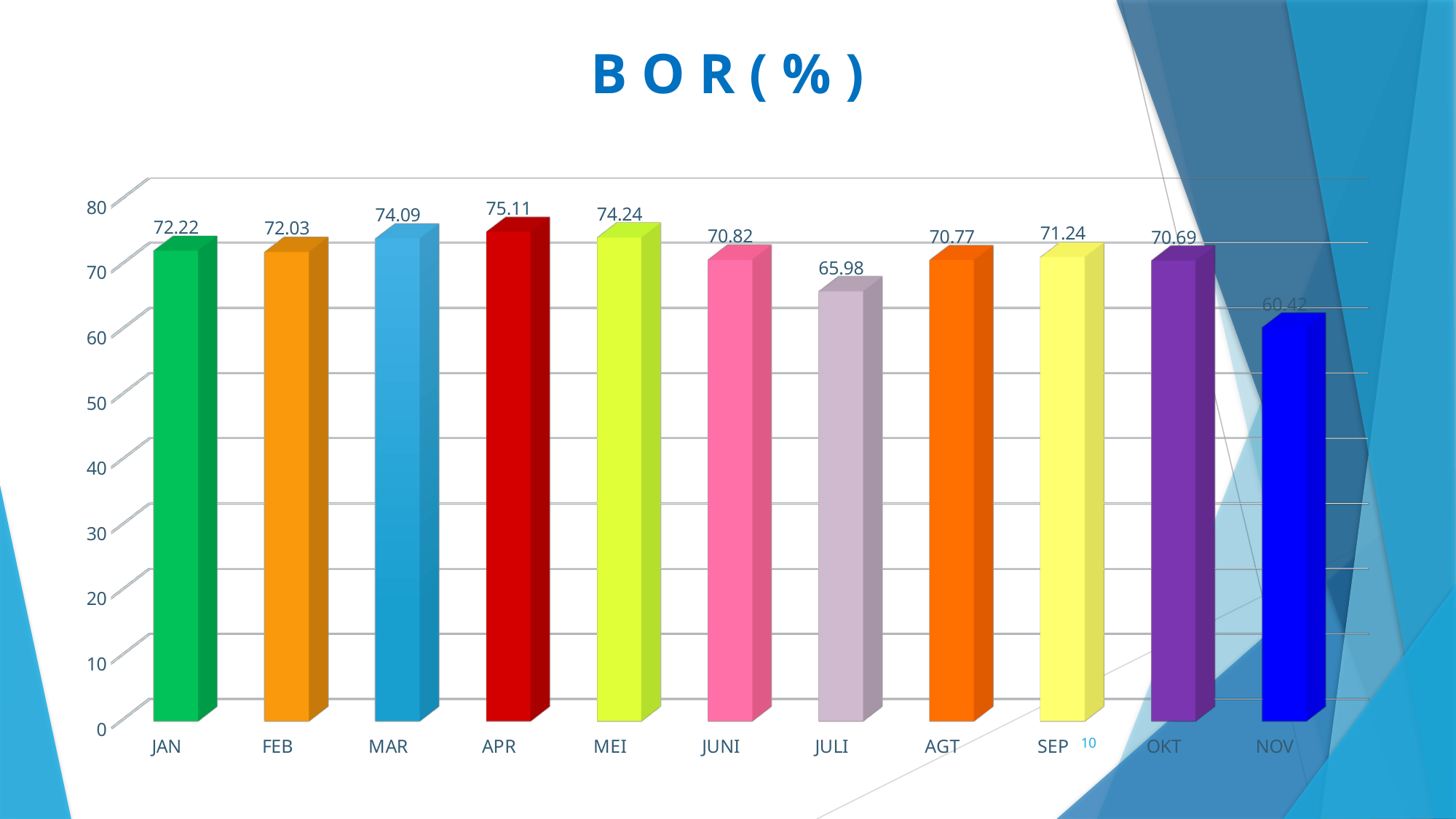
What is the BOR (%) value for JULI? 65.98 Which month has the highest BOR (%) value? APR What is the BOR (%) value for APR? 75.11 What is the title of the chart? BOR ( % ) What kind of chart is shown on the slide? bar chart How many months are shown on the x axis of the chart? 11 What is the difference between the BOR (%) values for APR and JULI? 9.13 Which has a larger BOR (%) value, JUNI or JULI? JUNI What is the difference between the BOR (%) values for JAN and FEB? 0.19 Which month has the lowest BOR (%) value? NOV Is the BOR (%) value for JULI greater or less than 70? less What is the BOR (%) value for SEP? 71.24